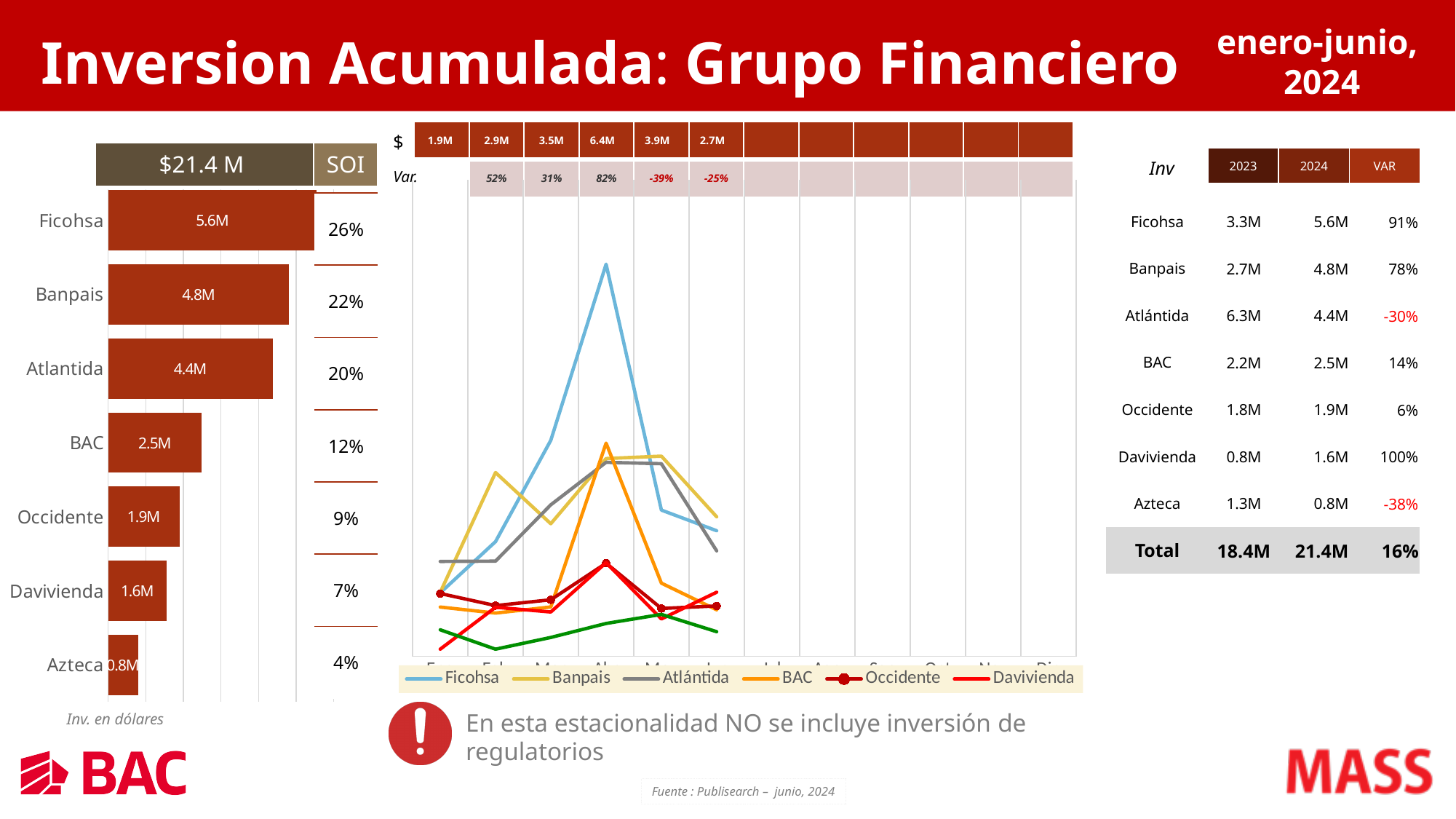
In the bar chart on the left, what is the value shown for Azteca? 0.8M How many series does the legend of the line chart in the middle list? 6 In the monthly totals row above the line chart, what is the value shown for the fourth month (Abr)? 6.4M In the bar chart on the left, what is the accumulated investment value for Ficohsa? 5.6M In the bar chart on the left, what is the difference between the values for Banpais and BAC? 2.3M In the bar chart on the left, what SOI percentage is shown for Banpais? 22% How many banks are shown as bars in the bar chart on the left? 7 In the bar chart on the left, which bank has the lowest accumulated investment? Azteca In the bar chart on the left, which bank has the highest accumulated investment? Ficohsa What type of chart is the chart on the left of the slide? Bar chart In the bar chart on the left, which is larger, the value for Atlantida or the value for Occidente? Atlantida In the line chart in the middle, which bank's line reaches the highest peak? Ficohsa